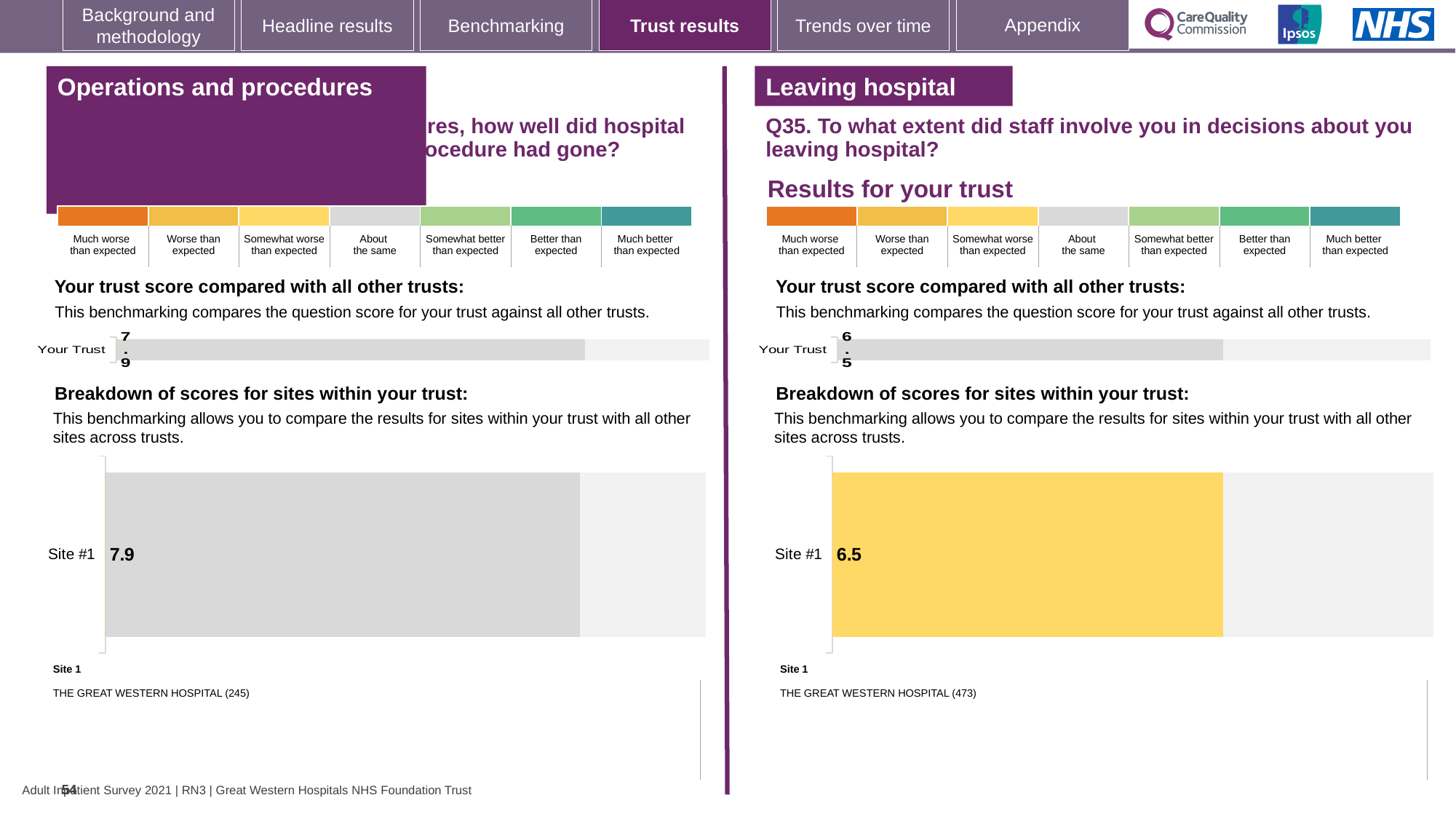
In the 'Breakdown of scores for sites within your trust' chart on the left-hand side, what is the value for Site #1? 7.9 Is the Site #1 value in the left-hand 'Operations and procedures' breakdown chart greater or less than the Site #1 value in the right-hand 'Leaving hospital' chart? greater What type of chart is used to show the Site #1 score in the right-hand 'Leaving hospital' section? Bar chart What is the difference between the Your Trust score on the left-hand section (7.9) and the Your Trust score on the right-hand section (6.5)? 1.4 What colour is the Site #1 bar in the right-hand 'Leaving hospital' breakdown chart? Yellow How many sites are shown in the 'Breakdown of scores for sites within your trust' chart on the left-hand side? 1 Which site name is listed as Site 1 under the right-hand 'Leaving hospital' chart? THE GREAT WESTERN HOSPITAL (473) How many sites are shown in the 'Breakdown of scores for sites within your trust' chart on the right-hand side? 1 Which is larger: the Site #1 score in the left-hand 'Operations and procedures' chart or the Site #1 score in the right-hand 'Leaving hospital' chart? Operations and procedures (7.9) On the right-hand 'Leaving hospital' section, what is the score shown for Your Trust? 6.5 In the 'Breakdown of scores for sites within your trust' chart on the right-hand side (Q35), what is the value for Site #1? 6.5 On the left-hand 'Operations and procedures' section, what is the score shown for Your Trust? 7.9